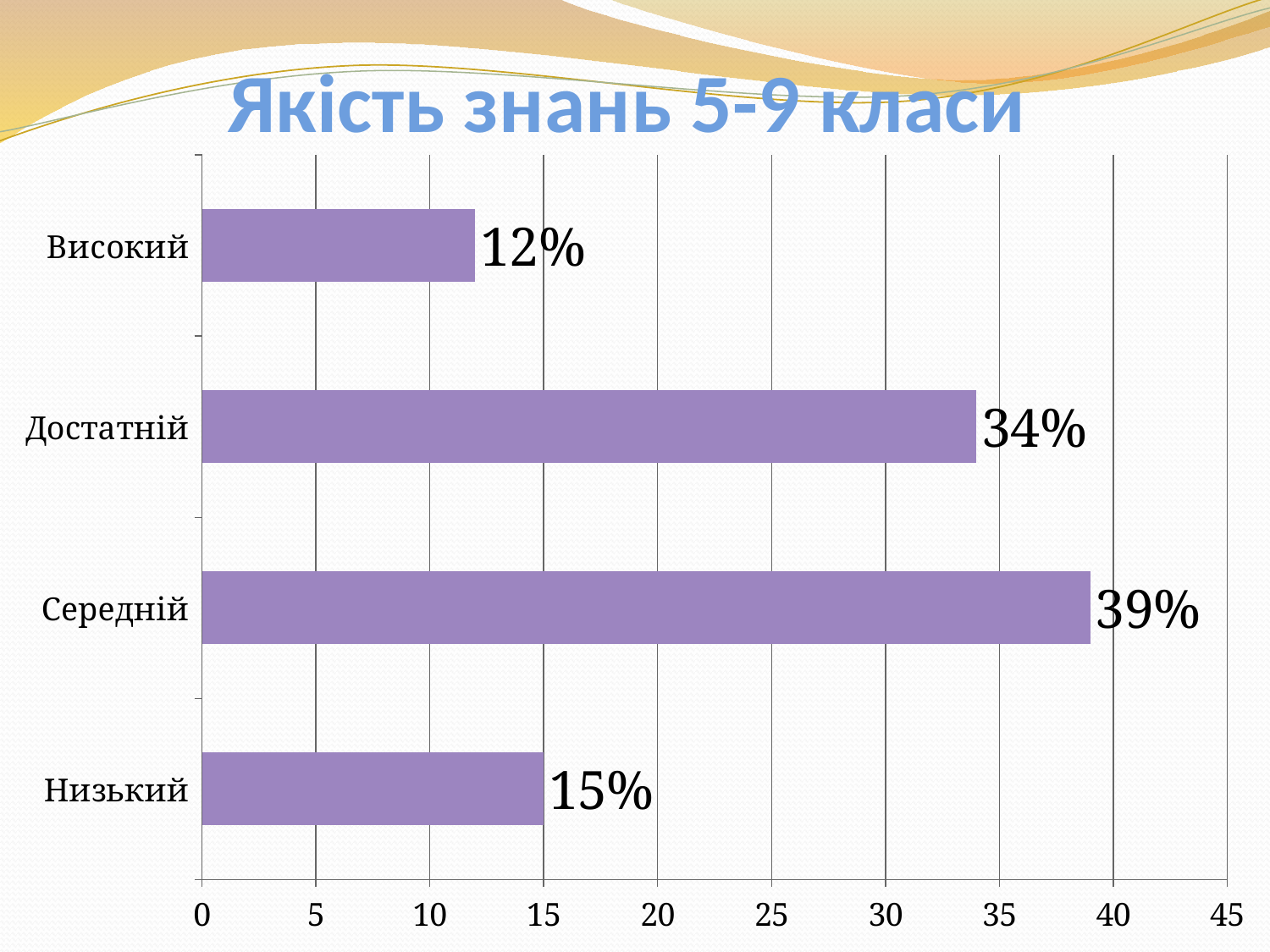
What is the value for Високий? 12% What is the value for Низький? 15% What is the difference between the values for Середній and Достатній? 5% What is the title of the chart? Якість знань 5-9 класи Which category has the lowest value? Високий What is the value for Достатній? 34% What kind of chart is shown on the slide? Bar chart Which is larger, the value for Низький or the value for Високий? Низький What is the difference between the values for Низький and Високий? 3% What is the value for Середній? 39% How many categories are shown in the chart? 4 Which category has the highest value? Середній